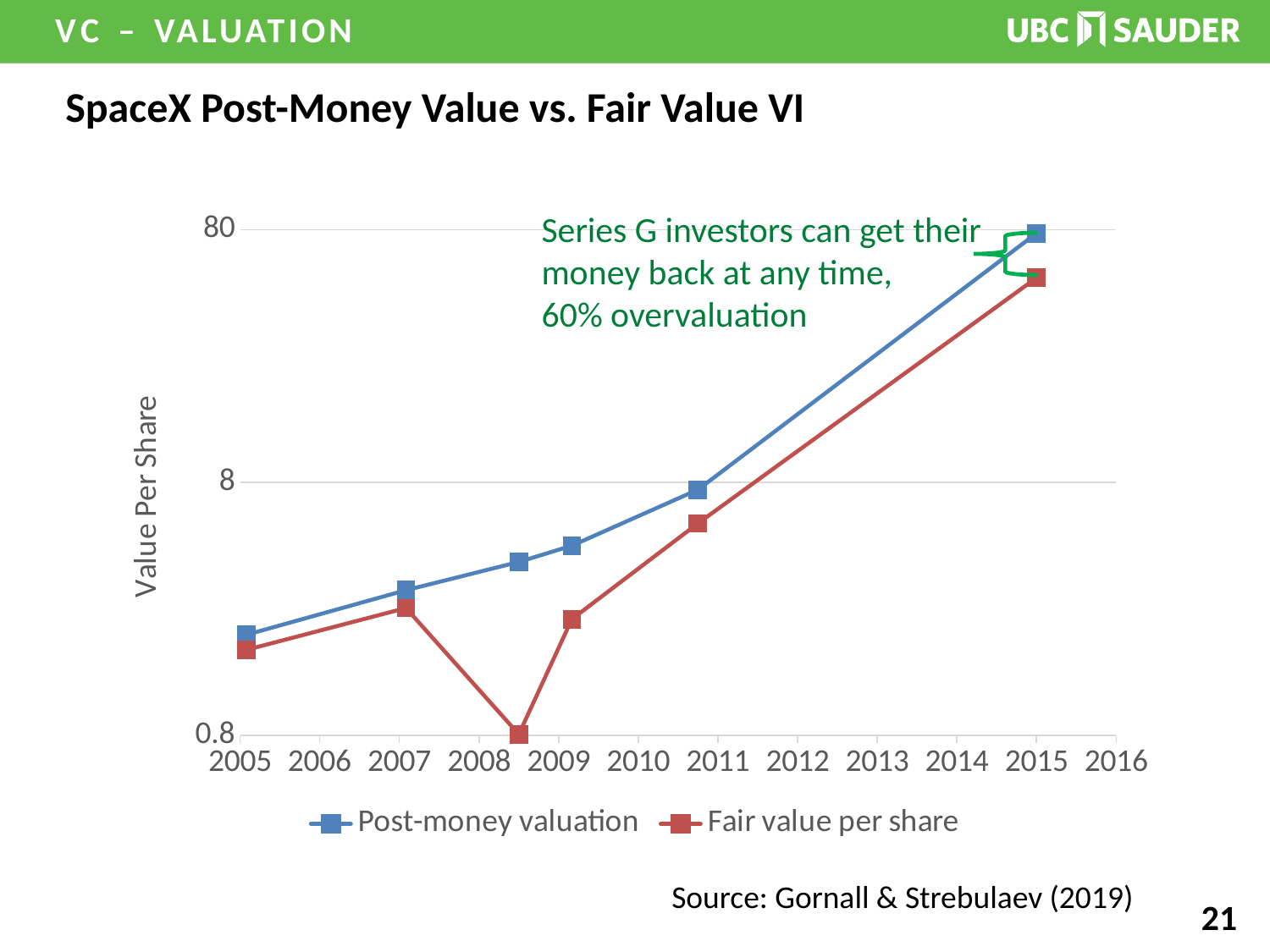
Is the Post-money valuation in 2015 greater or less than 8? greater In 2015, which is higher: the Post-money valuation or the Fair value per share? Post-money valuation Is the Fair value per share in 2008 greater or less than 8? less How many data points are plotted for the Post-money valuation series? 6 How many series does the legend list? 2 Does the Post-money valuation series rise or fall from 2005 to 2015? Rise In which year is the Post-money valuation at its highest? 2015 In which year is the Fair value per share at its lowest? 2008 What kind of chart is shown on the slide? Line chart Is the Post-money valuation in 2005 greater or less than 8? less According to the annotation on the chart, what is the overvaluation for Series G investors? 60% What are the two series named in the legend? Post-money valuation; Fair value per share